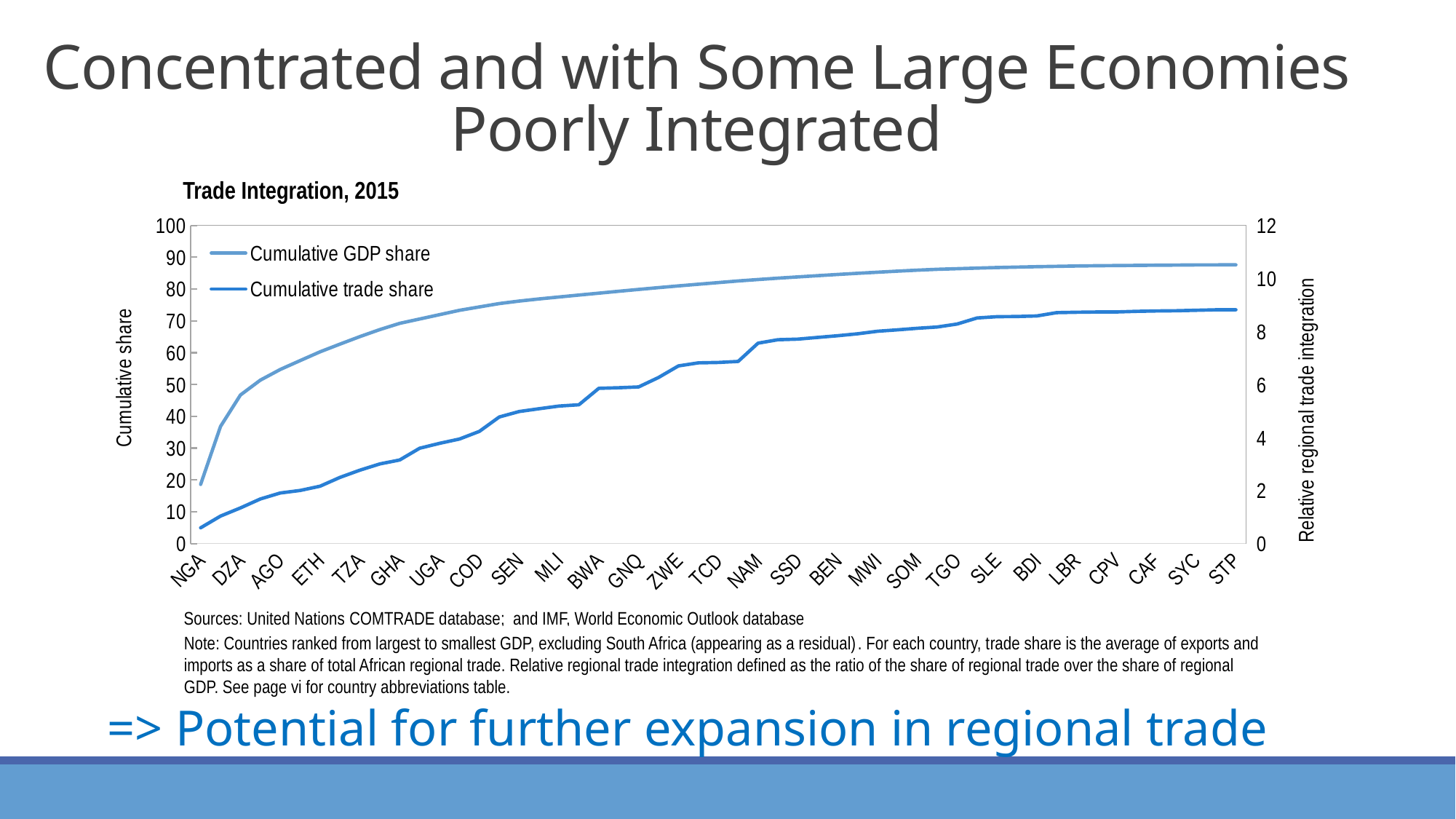
At NGA, which series has the larger value, Cumulative GDP share or Cumulative trade share? Cumulative GDP share Is the Cumulative trade share value for NAM greater or less than 60? greater What kind of chart is shown on the slide? line chart What is the title of the chart? Trade Integration, 2015 How many series does the legend list? 2 What is the label of the left vertical axis? Cumulative share Does the Cumulative trade share line rise or fall from NGA to STP? rise Is the Cumulative trade share value for NGA greater or less than 10? less Is the Cumulative trade share value for STP greater or less than 70? greater